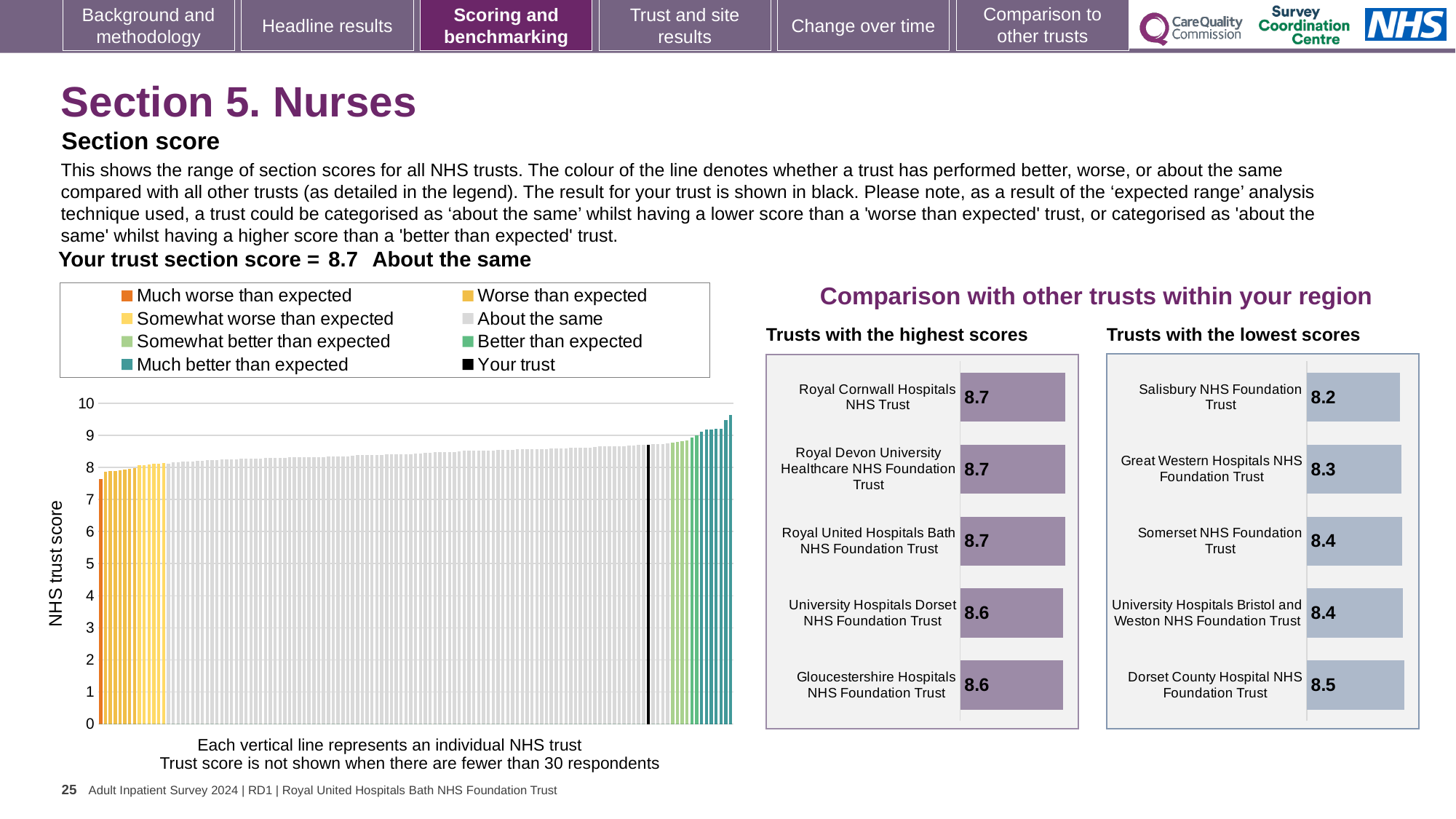
In the 'Trusts with the highest scores' chart, what is the score for Royal Cornwall Hospitals NHS Trust? 8.7 In the 'Trusts with the lowest scores' chart, what is the difference between the scores of Dorset County Hospital NHS Foundation Trust and Salisbury NHS Foundation Trust? 0.3 How many trusts are shown in the 'Trusts with the highest scores' chart? 5 In the 'Trusts with the lowest scores' chart, which has the larger score: Great Western Hospitals NHS Foundation Trust or Somerset NHS Foundation Trust? Somerset NHS Foundation Trust In the 'Trusts with the highest scores' chart, what is the score for Gloucestershire Hospitals NHS Foundation Trust? 8.6 In the 'Trusts with the lowest scores' chart, which trust has the lowest score? Salisbury NHS Foundation Trust What kind of chart is the main chart on the left showing the range of NHS trust scores? Bar chart In the 'Trusts with the lowest scores' chart, which trust has the highest score? Dorset County Hospital NHS Foundation Trust In the main chart on the left, is the value of the black bar representing your trust greater or less than 8? greater In the main chart on the left showing the range of section scores, how many entries does the legend list? 8 In the 'Trusts with the lowest scores' chart, what is the score for Salisbury NHS Foundation Trust? 8.2 In the main chart on the left, do the trust scores rise or fall from left to right along the x axis? Rise